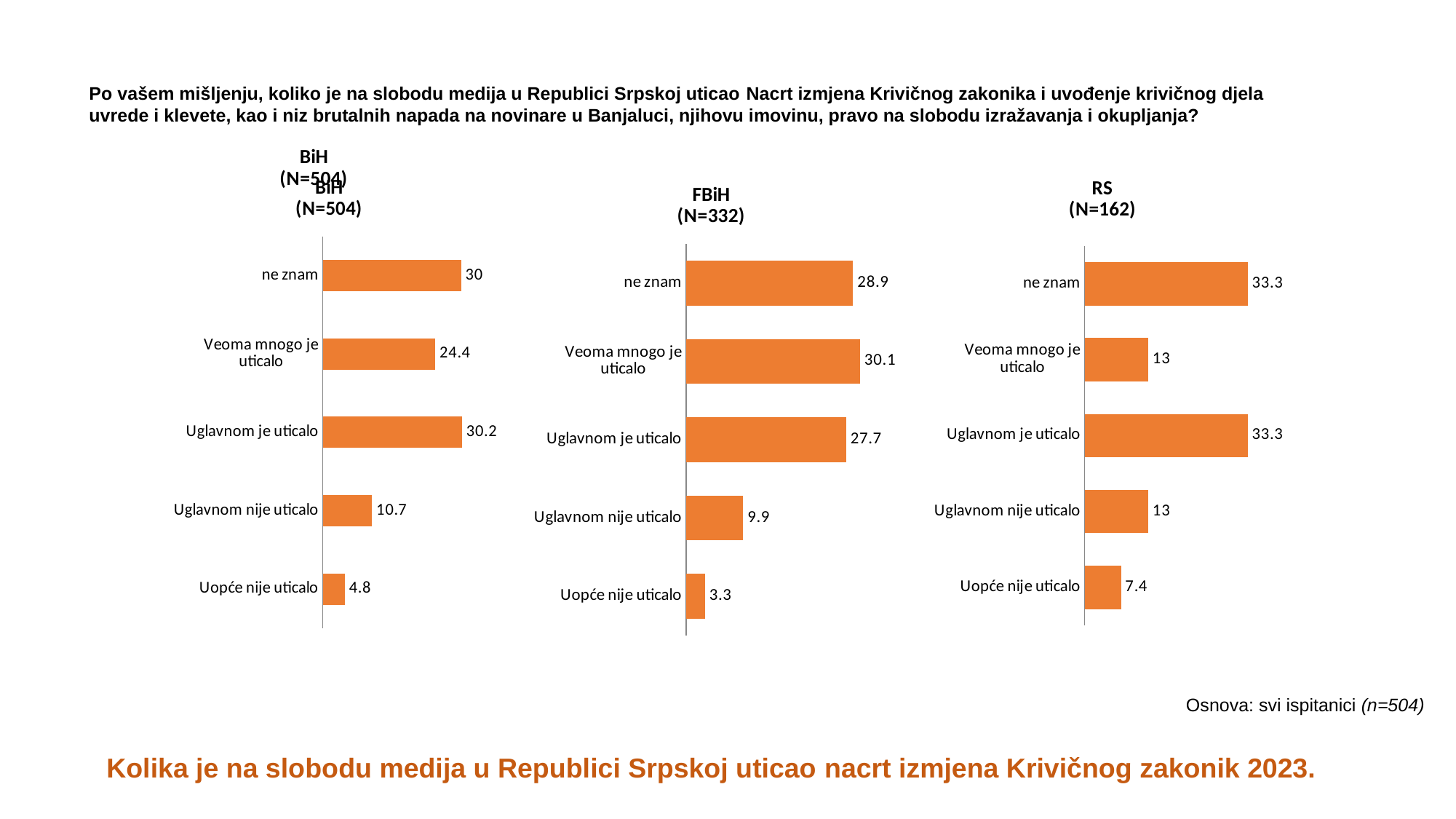
In the RS (N=162) chart, what is the difference between "ne znam" and "Veoma mnogo je uticalo"? 20.3 How many charts are shown on the slide? 3 In the RS (N=162) chart, which category has the lowest value? Uopće nije uticalo In the FBiH (N=332) chart, which category has the lowest value? Uopće nije uticalo What kind of chart is the BiH (N=504) chart? bar chart In the FBiH (N=332) chart, what is the value for "Veoma mnogo je uticalo"? 30.1 In the BiH (N=504) chart, what is the value for "Uglavnom nije uticalo"? 10.7 In the BiH (N=504) chart, what is the difference between "Veoma mnogo je uticalo" and "Uglavnom nije uticalo"? 13.7 In the FBiH (N=332) chart, which is larger: "ne znam" or "Uglavnom nije uticalo"? ne znam In the FBiH (N=332) chart, which category has the highest value? Veoma mnogo je uticalo In the RS (N=162) chart, what is the value for "Uopće nije uticalo"? 7.4 How many categories are shown in the RS (N=162) chart? 5